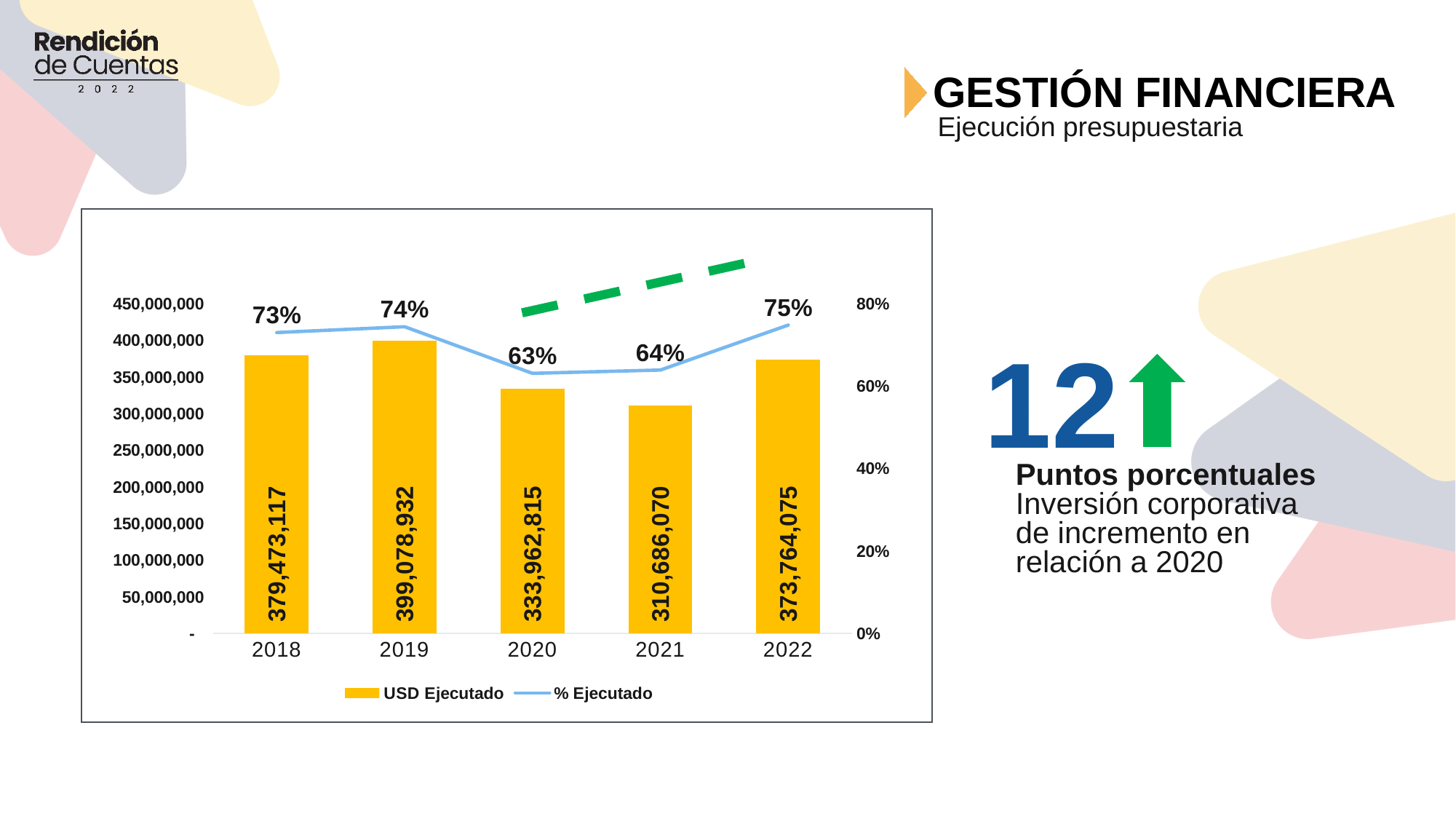
Which year has the lowest % Ejecutado? 2020 What is the difference in USD Ejecutado between 2019 and 2021? 88,392,862 How many years are shown on the x axis? 5 Does the % Ejecutado rise or fall from 2020 to 2022? Rise What is the difference in % Ejecutado between 2022 and 2020? 12 percentage points Which year has the highest USD Ejecutado? 2019 What is the USD Ejecutado value for 2019? 399,078,932 What is the % Ejecutado value for 2020? 63% What is the USD Ejecutado value for 2021? 310,686,070 How many series does the legend list? 2 What kind of chart is shown on the slide? Combined bar and line chart Which is larger, the USD Ejecutado for 2018 or for 2022? 2018